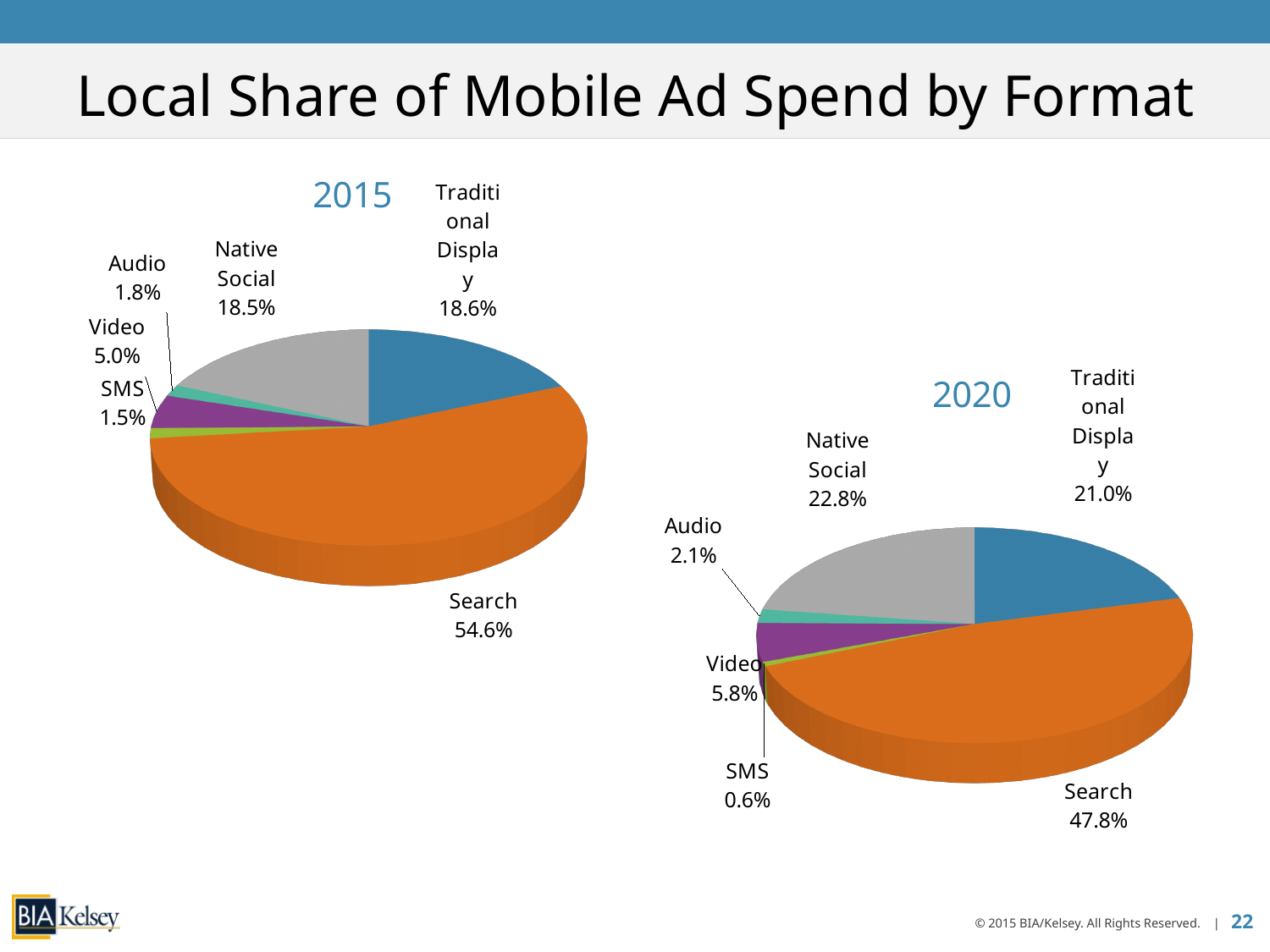
Which is larger: the Video share in 2015 or the Video share in 2020? Video share in 2020 What is the difference between the Search share in 2015 and the Search share in 2020? 6.8% How many slices does the 2015 pie chart have? 6 In the 2015 pie chart, which format has the smallest share? SMS In the 2020 pie chart, what share does SMS have? 0.6% What type of chart is used to show the 2020 data? Pie chart In the 2020 pie chart, which format has the largest share? Search In the 2020 pie chart, what share does Native Social have? 22.8% In the 2015 pie chart, what share does Search have? 54.6% In the 2020 pie chart, what is the difference between the Native Social share and the Traditional Display share? 1.8% In the 2020 pie chart, which format has the smallest share? SMS In the 2015 pie chart, what share does Traditional Display have? 18.6%